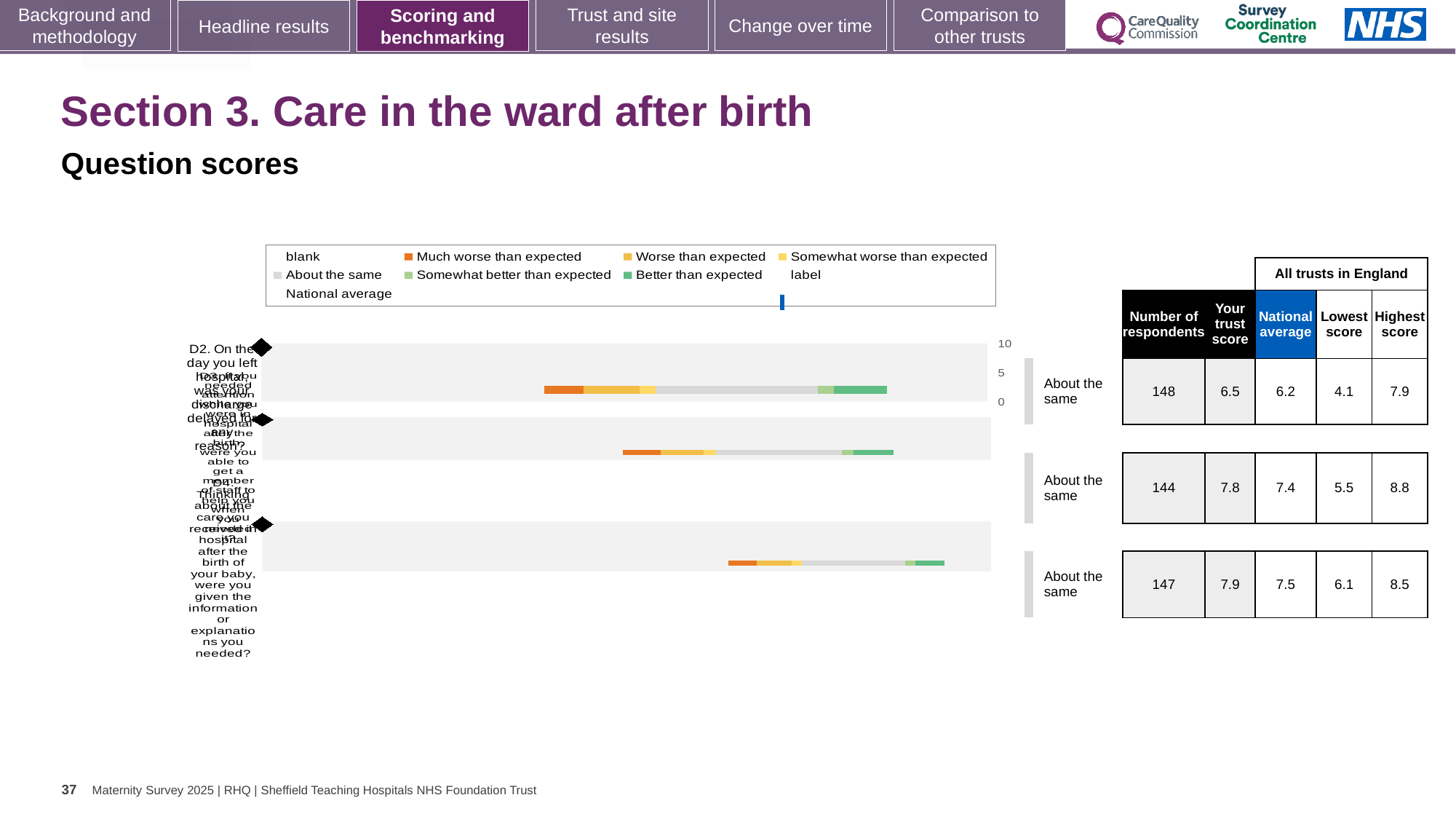
Which question row has the lowest 'Lowest score' value in the table? the first (top) row, 4.1 Which is larger: the 'Highest score' for the second question row or for the third question row? the second row (8.8) How many question rows (bars) are plotted in the chart? 3 What kind of chart is shown on the slide? bar chart In the table beside the chart, what is the number of respondents for the first (top) question row? 148 Which question row has the highest 'Your trust score' in the table? the third (bottom) row, 7.9 What benchmark category is shown next to each of the three question rows? About the same In the table beside the chart, what is the national average for the third (bottom) question row? 7.5 What colour represents 'Much worse than expected' in the chart legend? orange In the table beside the chart, what is the 'Your trust score' for the second question row? 7.8 For the first (top) question row, what is the difference between the trust score (6.5) and the national average (6.2)? 0.3 What does the blue vertical marker in the legend represent? National average